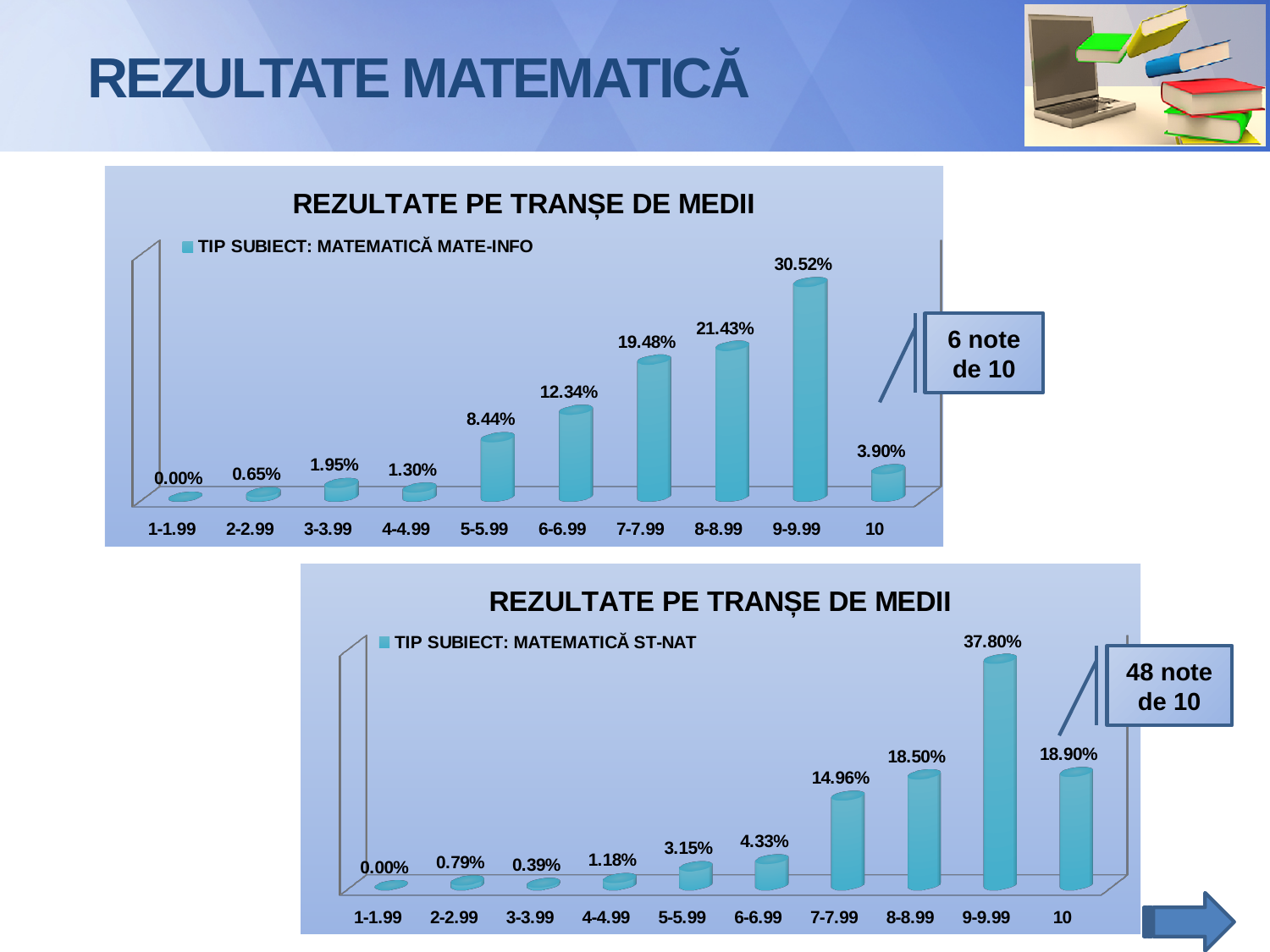
In the top chart (MATEMATICĂ MATE-INFO), what is the difference between the values for 8-8.99 and 7-7.99? 1.95% In the top chart (MATEMATICĂ MATE-INFO), which range has the highest value? 9-9.99 In the bottom chart (MATEMATICĂ ST-NAT), what is the value for the 7-7.99 range? 14.96% In the top chart (MATEMATICĂ MATE-INFO), which is larger: the value for 5-5.99 or the value for 6-6.99? 6-6.99 What is the legend entry of the bottom chart? TIP SUBIECT: MATEMATICĂ ST-NAT What kind of chart is the top chart (MATEMATICĂ MATE-INFO)? bar chart In the top chart (MATEMATICĂ MATE-INFO), what is the value for the 9-9.99 range? 30.52% In the bottom chart (MATEMATICĂ ST-NAT), what is the difference between the values for 9-9.99 and 10? 18.90% In the bottom chart (MATEMATICĂ ST-NAT), which is larger: the value for 8-8.99 or the value for 10? 10 How many categories are shown on the x axis of the top chart (MATEMATICĂ MATE-INFO)? 10 In the bottom chart (MATEMATICĂ ST-NAT), which range has the lowest value? 1-1.99 How many series does the legend of the bottom chart (MATEMATICĂ ST-NAT) list? 1